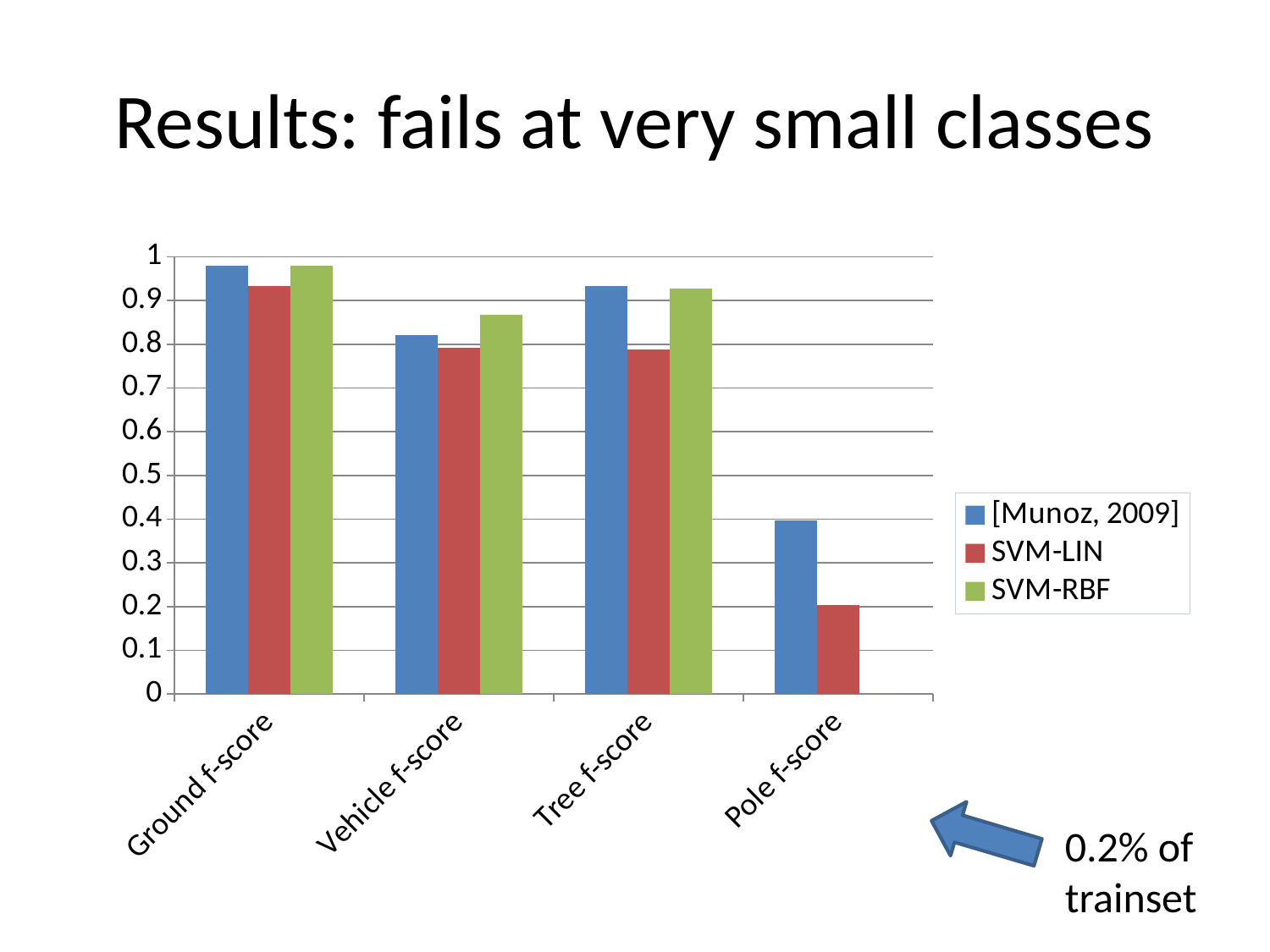
For Vehicle f-score, which is larger: SVM-RBF or SVM-LIN? SVM-RBF For which category is the SVM-LIN value lowest? Pole f-score Is the SVM-LIN value for Pole f-score greater or less than 0.3? less Is the SVM-LIN value for Tree f-score greater or less than 0.7? greater How many categories are shown on the x axis of the chart? 4 Is the SVM-RBF value for Vehicle f-score greater or less than 0.8? greater What kind of chart is shown on the slide? bar chart For which category is the SVM-LIN value highest? Ground f-score How many series does the chart's legend list? 3 For Pole f-score, which is larger: [Munoz, 2009] or SVM-LIN? [Munoz, 2009] Which series are listed in the chart's legend? [Munoz, 2009], SVM-LIN, SVM-RBF